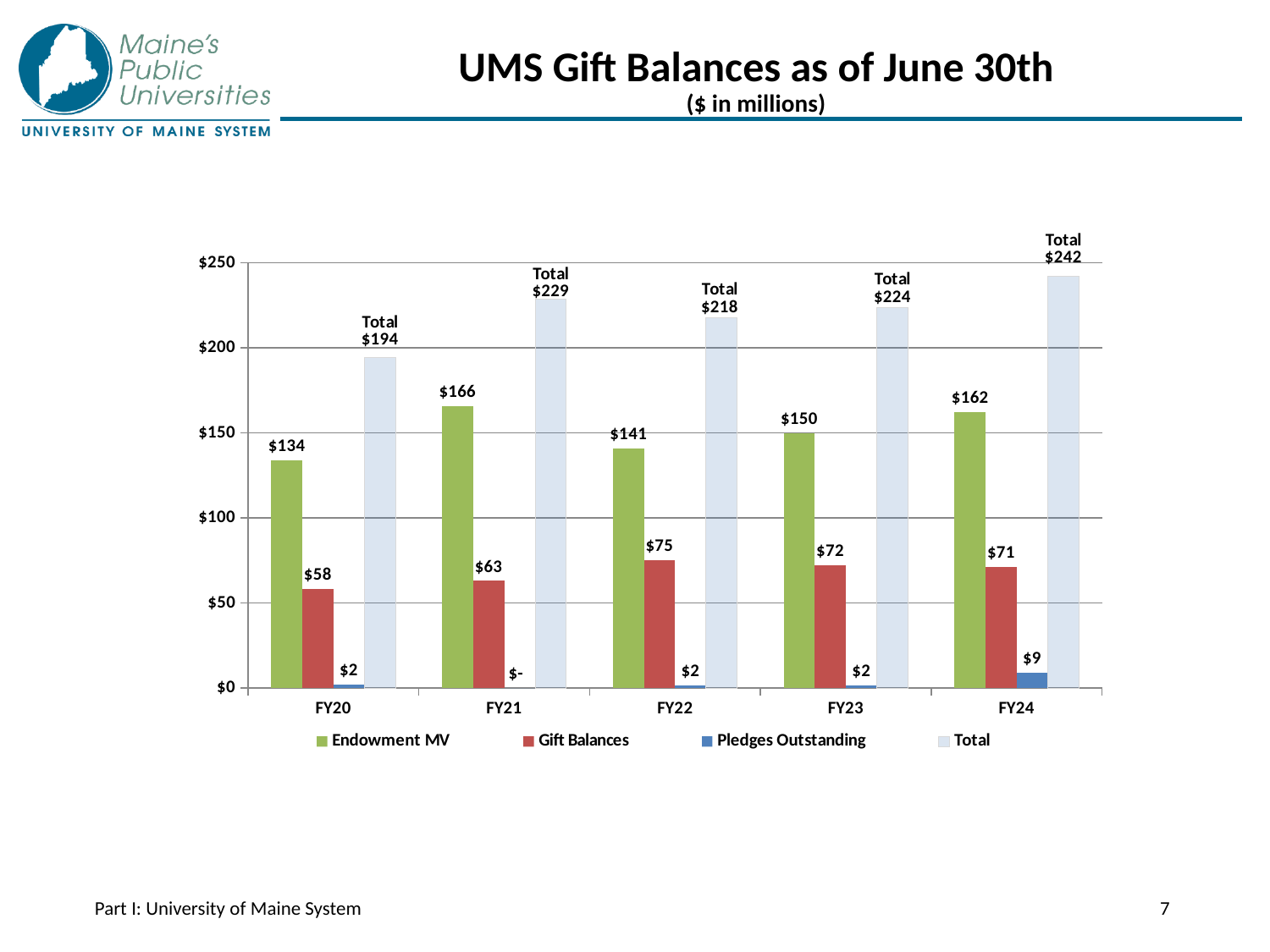
What is the difference between the Endowment MV for FY21 and FY20? $32 Which is larger, the Gift Balances value for FY23 or for FY24? FY23 What is the Pledges Outstanding value for FY24? $9 What is the Gift Balances value for FY22? $75 Which fiscal year has the lowest Endowment MV? FY20 How many series does the legend list? 4 How many fiscal years are shown on the x axis? 5 Which fiscal year has the highest Total? FY24 What is the Total value for FY24? $242 What kind of chart is shown on the slide? Bar chart What is the Endowment MV value for FY21? $166 What is the title of the chart? UMS Gift Balances as of June 30th